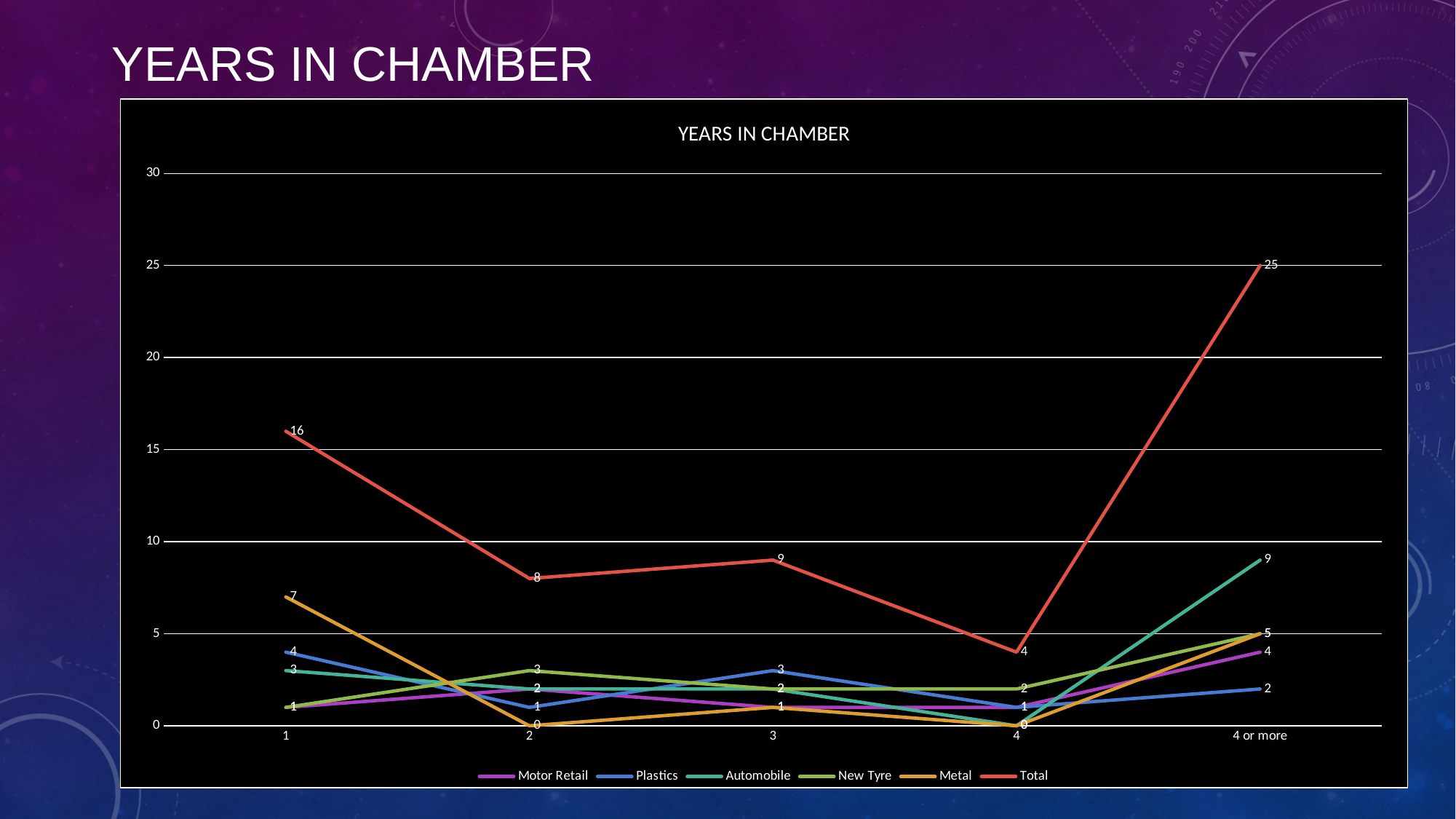
For which category is the Total series highest? 4 or more What is the Automobile value for the '4 or more' category? 9 What is the Total value for category 1? 16 What is the Total value for the '4 or more' category? 25 How many categories are shown on the x axis? 5 What type of chart is shown on the slide? line chart What is the Metal value for category 1? 7 What is the Total value for category 4? 4 What is the difference between the Total value for '4 or more' and the Total value for category 1? 9 Which is larger, the Total value for category 2 or the Total value for category 3? category 3 For which category is the Total series lowest? 4 How many series does the legend list? 6